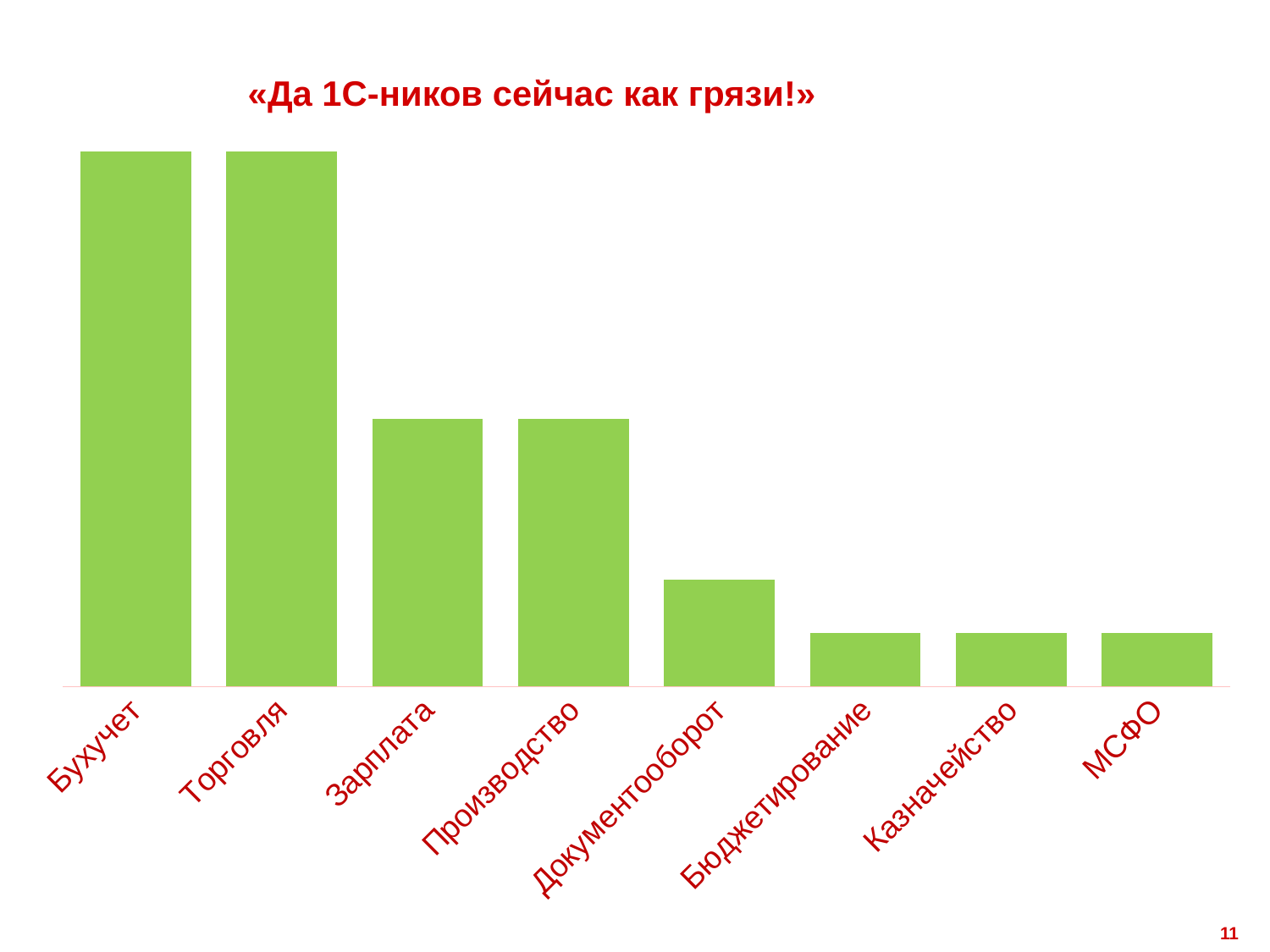
Which is larger, the bar for Документооборот or the bar for МСФО? Документооборот What kind of chart is shown on the slide? bar chart What colour are the bars in the chart? green Which is larger, the bar for Бухучет or the bar for Зарплата? Бухучет What is the label of the first category on the x axis? Бухучет Which is larger, the bar for Зарплата or the bar for Бюджетирование? Зарплата Do the bar values generally rise or fall from left to right along the x axis? fall How many categories are shown on the x axis of the chart? 8 What is the title shown above the chart? «Да 1С-ников сейчас как грязи!»